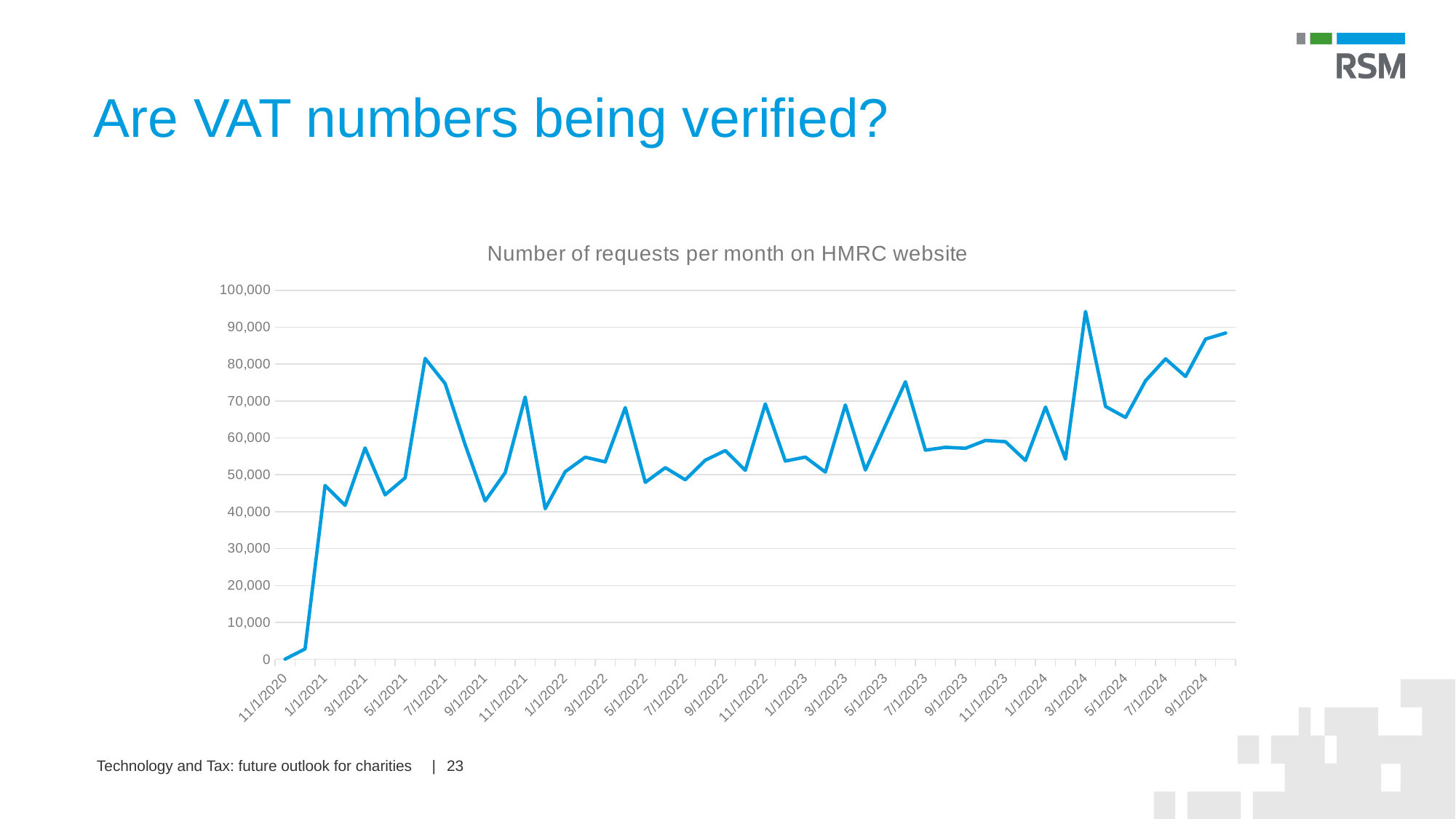
Is the value for 3/1/2024 greater or less than 90,000? greater Which date on the x axis has the highest number of requests? 3/1/2024 What is the title of the chart? Number of requests per month on HMRC website Which date on the x axis has the lowest number of requests? 11/1/2020 What kind of chart is shown on the slide? line chart Overall, do the number of requests rise or fall from 11/1/2020 to 9/1/2024? rise Is the value for 7/1/2021 greater or less than 70,000? greater What is the highest value shown on the vertical axis of the chart? 100,000 Which has the higher number of requests, 3/1/2024 or 7/1/2021? 3/1/2024 Is the value for 9/1/2024 greater or less than 80,000? greater